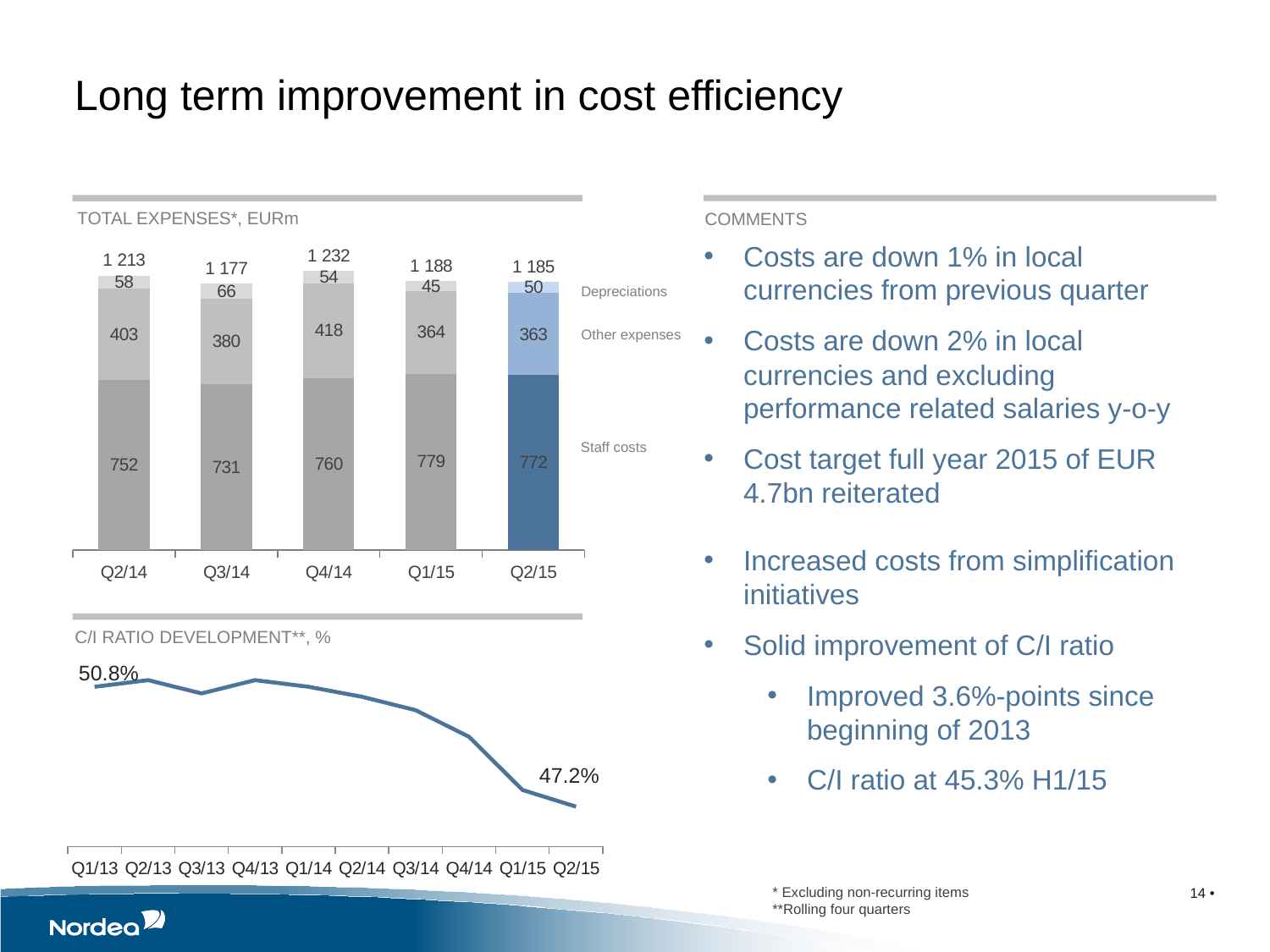
How many quarters are shown in the TOTAL EXPENSES chart? 5 In the TOTAL EXPENSES chart, what is the value for depreciations in Q3/14? 66 In the TOTAL EXPENSES chart, which quarter has the highest total expenses? Q4/14 How many series does the TOTAL EXPENSES chart show? 3 In the C/I RATIO DEVELOPMENT chart, does the C/I ratio rise or fall from Q1/13 to Q2/15? Fall In the TOTAL EXPENSES chart, which quarter has the lowest total expenses? Q3/14 In the TOTAL EXPENSES chart, what are the staff costs for Q1/15? 779 What kind of chart is the C/I RATIO DEVELOPMENT chart? Line chart In the TOTAL EXPENSES chart, what is the total for Q4/14? 1 232 In the TOTAL EXPENSES chart, are staff costs higher in Q2/14 or Q3/14? Q2/14 In the TOTAL EXPENSES chart, what is the difference in other expenses between Q4/14 and Q1/15? 54 In the C/I RATIO DEVELOPMENT chart, what is the value for Q2/15? 47.2%